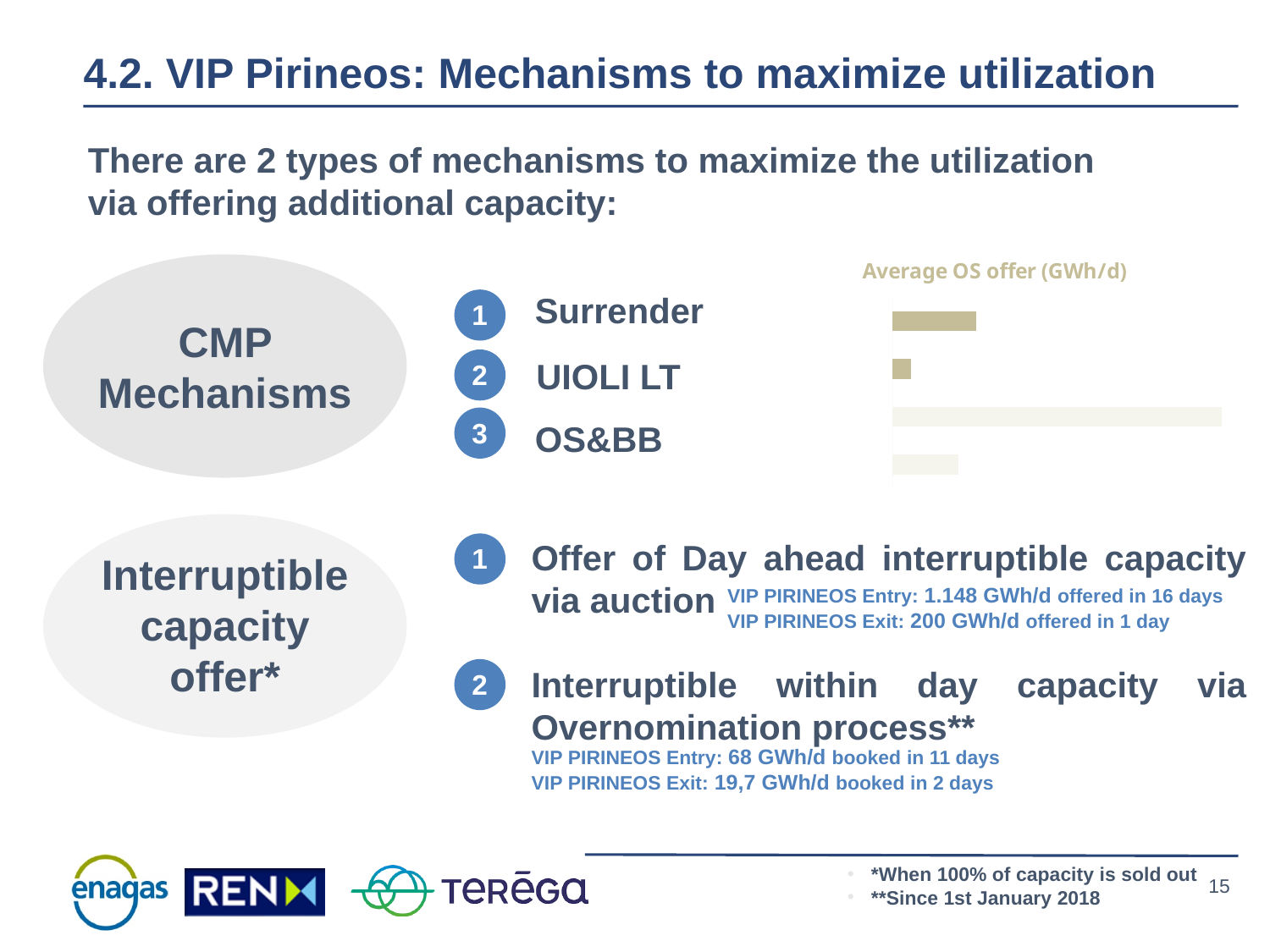
How many bars are plotted in the 'Average OS offer (GWh/d)' chart? 4 What is the title of the chart on the right side of the slide? Average OS offer (GWh/d) In the 'Average OS offer (GWh/d)' chart, which bar is the shortest, counting from the top? the second bar What kind of chart is shown on the right of the slide under the heading 'Average OS offer (GWh/d)'? bar chart Are the bars in the 'Average OS offer (GWh/d)' chart horizontal or vertical? horizontal In the 'Average OS offer (GWh/d)' chart, which bar is the longest, counting from the top? the third bar In the 'Average OS offer (GWh/d)' chart, is the first bar from the top longer or shorter than the second bar? longer